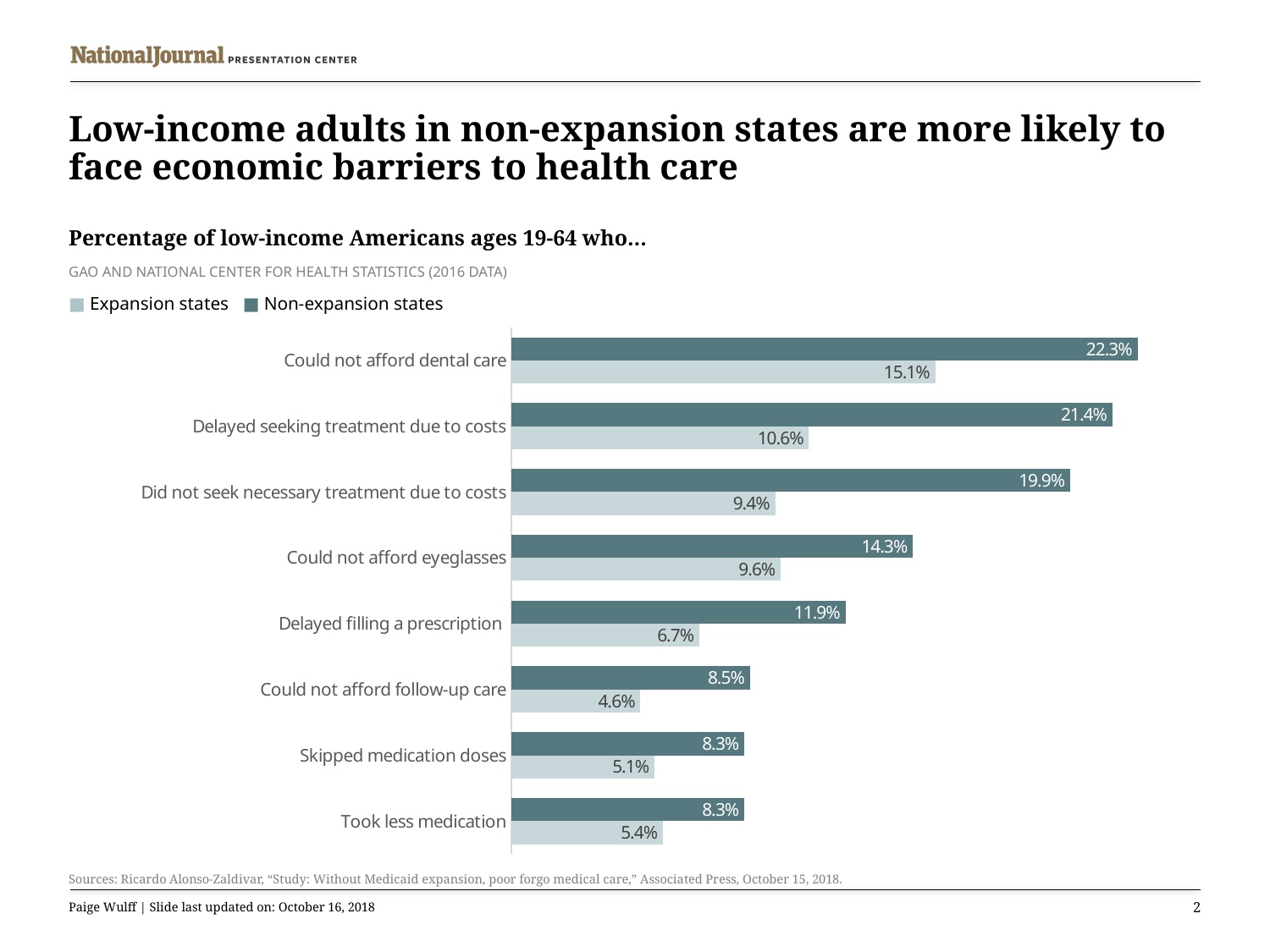
What is the value for expansion states for 'Could not afford follow-up care'? 4.6% How many series does the legend list? 2 What is the data source noted beneath the chart subtitle? GAO and National Center for Health Statistics (2016 data) How many categories are shown in the chart? 8 Which category has the lowest value for expansion states? Could not afford follow-up care What kind of chart is shown on the slide? Bar chart Which is larger: the expansion states value for 'Could not afford eyeglasses' or the expansion states value for 'Did not seek necessary treatment due to costs'? Could not afford eyeglasses What percentage of low-income adults in non-expansion states could not afford dental care? 22.3% What is the difference between non-expansion and expansion states for 'Did not seek necessary treatment due to costs'? 10.5 percentage points Which category has the highest value for non-expansion states? Could not afford dental care What percentage of low-income adults in expansion states delayed seeking treatment due to costs? 10.6% What is the difference between non-expansion and expansion states for 'Could not afford dental care'? 7.2 percentage points